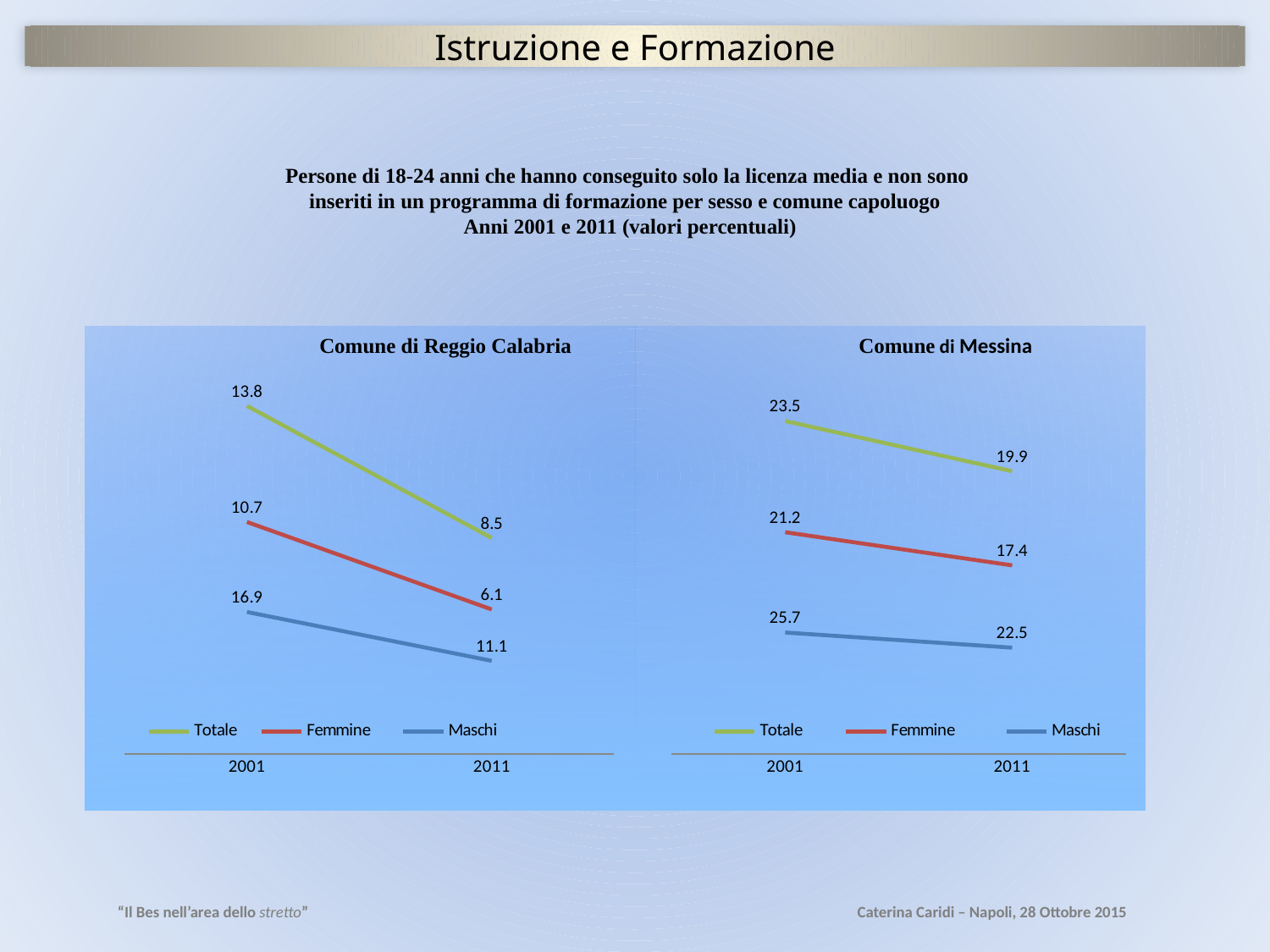
In the Comune di Messina chart, what is the value for Totale in 2011? 19.9 In the Comune di Messina chart, what is the difference between the Maschi and Femmine values in 2001? 4.5 What kind of chart is the Comune di Messina chart? line chart In the Comune di Messina chart, which is larger: the Totale value in 2001 or the Totale value in 2011? 2001 In the Comune di Reggio Calabria chart, by how much did the Totale value fall from 2001 to 2011? 5.3 In the Comune di Messina chart, what is the value for Maschi in 2001? 25.7 In the Comune di Reggio Calabria chart, what is the value for Totale in 2001? 13.8 In the Comune di Reggio Calabria chart, what is the value for Femmine in 2011? 6.1 How many series does the legend of the Comune di Reggio Calabria chart list? 3 In the Comune di Messina chart, what is the value for Femmine in 2011? 17.4 In the Comune di Messina chart, does the Femmine value rise or fall from 2001 to 2011? fall In the Comune di Reggio Calabria chart, what is the value for Maschi in 2001? 16.9